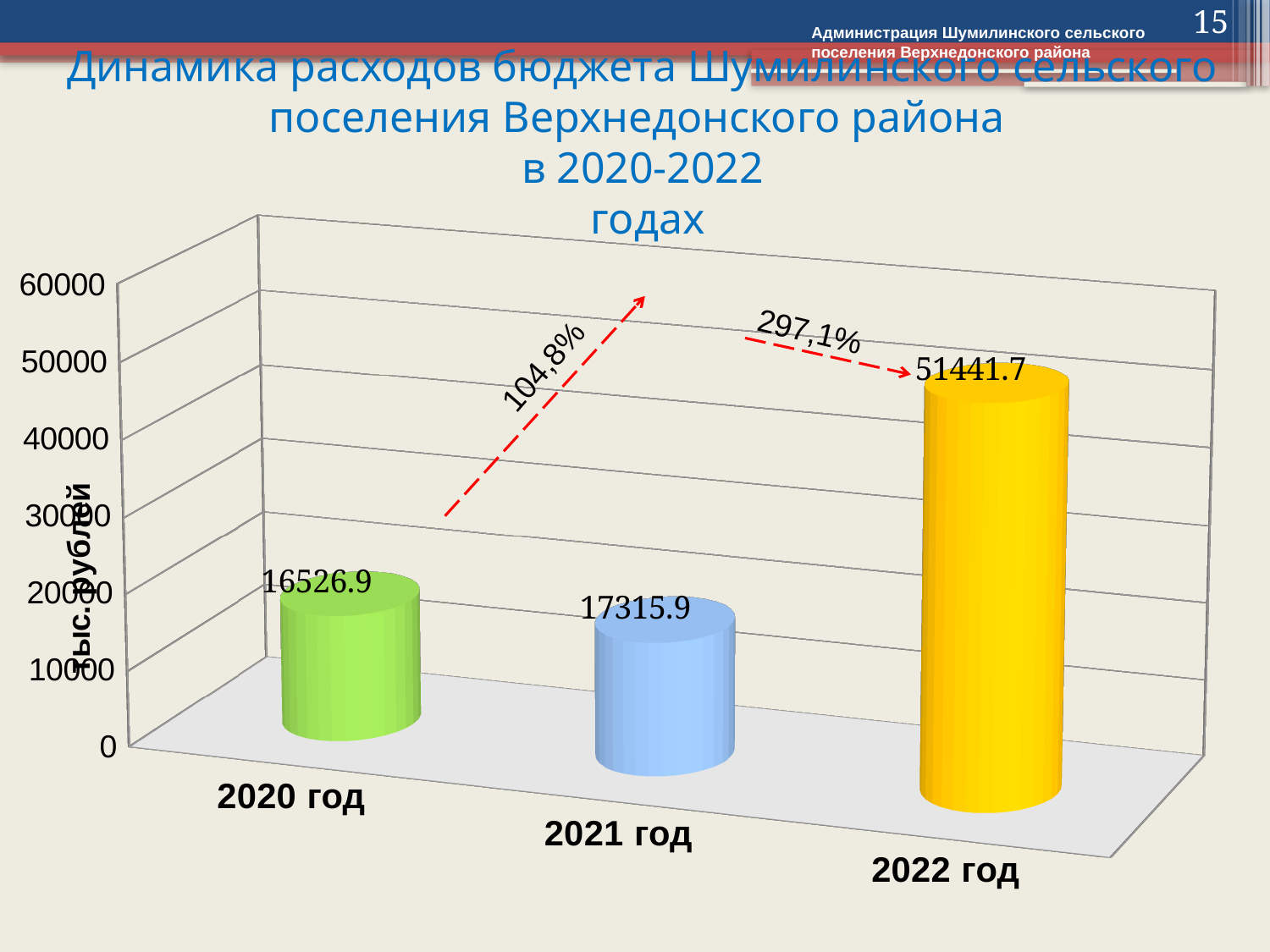
Which year has the highest value? 2022 год What is the value for 2021 год? 17315.9 What kind of chart is shown on the slide? bar chart Which is larger, the value for 2022 год or the value for 2021 год? 2022 год How many years are shown on the chart? 3 What percentage is written on the arrow between 2021 год and 2022 год? 297,1% Is the value for 2022 год greater or less than 40000? greater What is the value for 2022 год? 51441.7 What is the difference between the values for 2021 год and 2020 год? 789.0 What is the difference between the values for 2022 год and 2021 год? 34125.8 What is the value for 2020 год? 16526.9 Which year has the lowest value? 2020 год